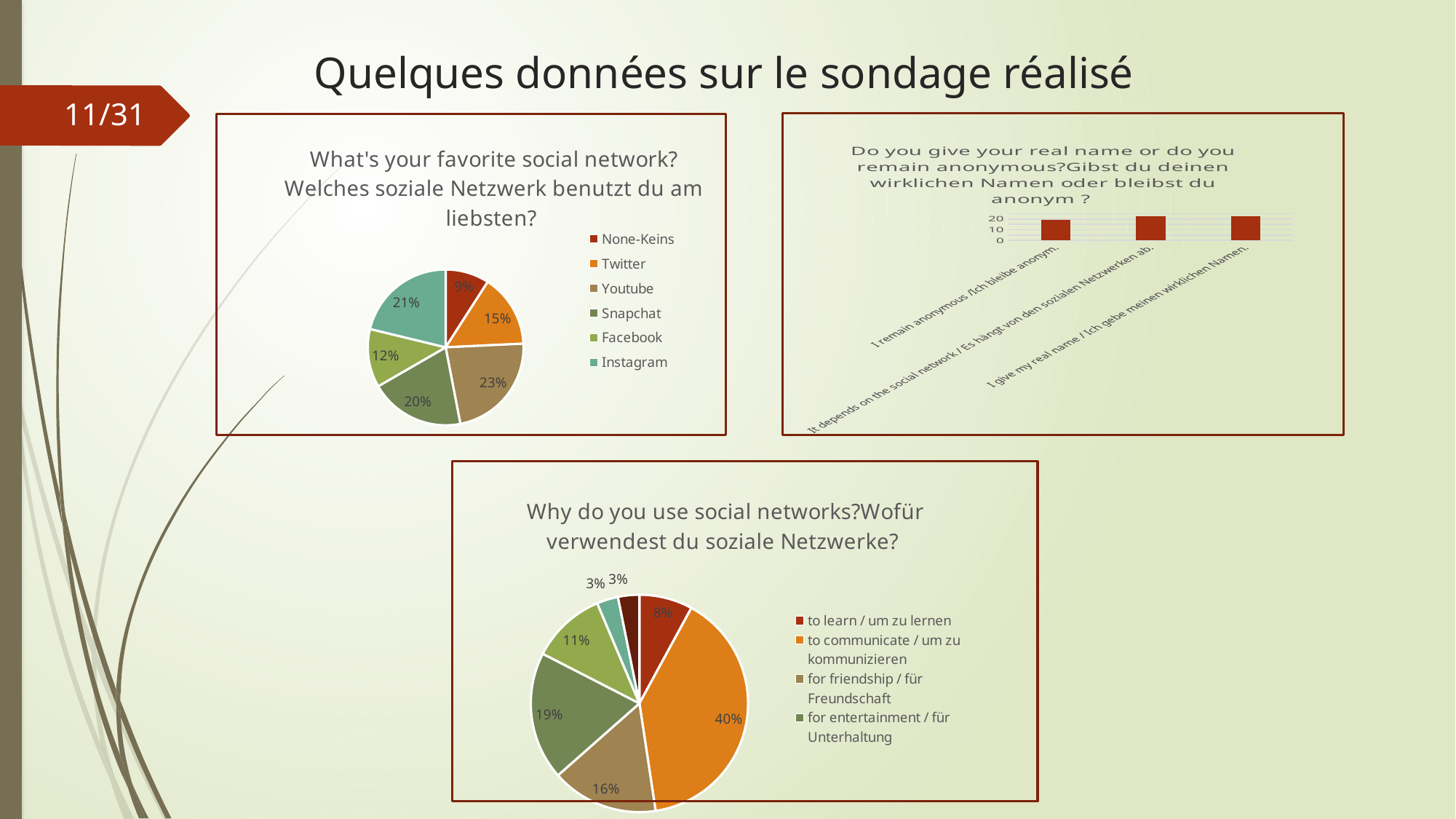
In the 'What's your favorite social network?' pie chart, what share is Instagram? 21% In the 'What's your favorite social network?' pie chart, which category has the smallest share? None-Keins In the 'Why do you use social networks?' pie chart, what share is 'to communicate / um zu kommunizieren'? 40% In the 'What's your favorite social network?' pie chart, which social network has the largest share? Youtube In the 'Do you give your real name or do you remain anonymous?' chart, is the value for 'I remain anonymous' greater or less than 10? greater In the 'What's your favorite social network?' pie chart, what share is Youtube? 23% What kind of chart is the 'Do you give your real name or do you remain anonymous?' chart? bar chart How many entries does the legend of the 'What's your favorite social network?' chart list? 6 How many bars are in the 'Do you give your real name or do you remain anonymous?' chart? 3 In the 'Why do you use social networks?' pie chart, which is larger: 'for friendship' or 'for entertainment'? for entertainment In the 'What's your favorite social network?' pie chart, what is the difference between the Snapchat and Facebook shares? 8% In the 'Why do you use social networks?' pie chart, what is the difference between 'to communicate' and 'to learn'? 32%